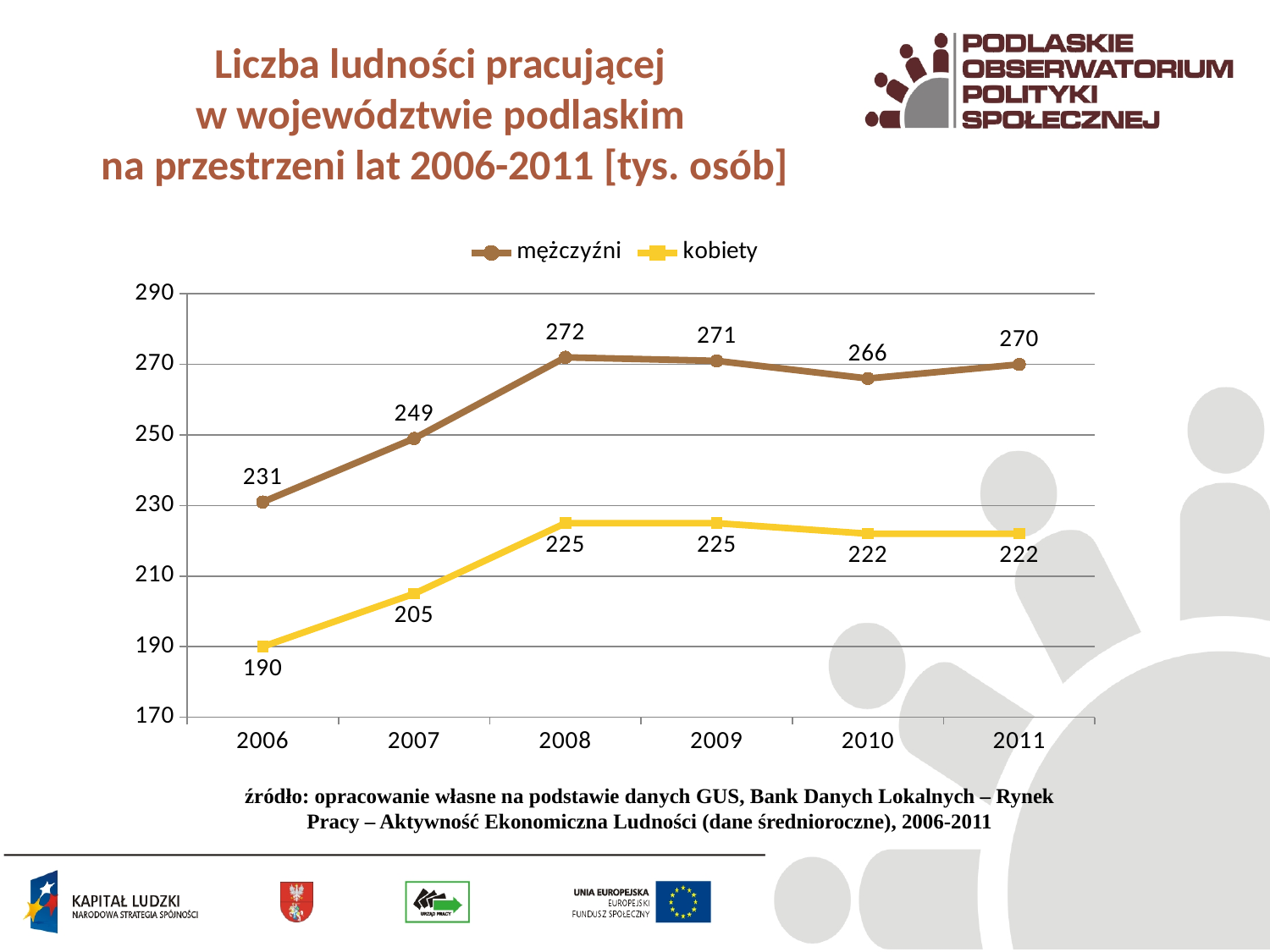
What is the difference between mężczyźni and kobiety in 2011? 48 Is the value for kobiety in 2009 greater or less than 230? less What kind of chart is shown on the slide? line chart How many series does the legend list? 2 Which is larger: the value for mężczyźni in 2007 or in 2010? 2010 What is the value for kobiety in 2006? 190 How many years are shown on the x axis? 6 What is the value for kobiety in 2010? 222 What is the value for mężczyźni in 2008? 272 In which year is the value for kobiety lowest? 2006 Does the value for mężczyźni rise or fall from 2006 to 2008? rise In which year is the value for mężczyźni highest? 2008